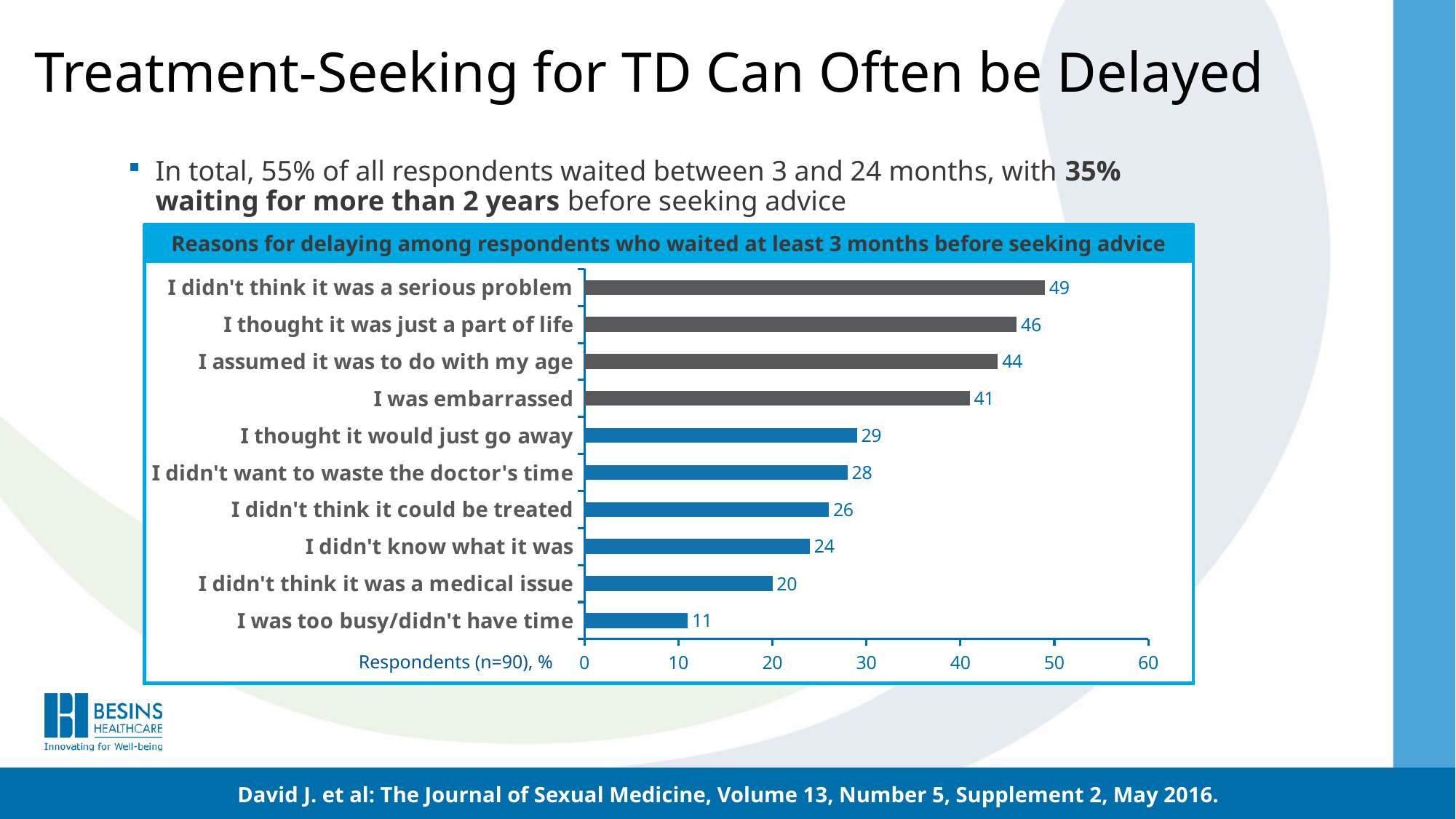
Which is larger: the value for "I thought it would just go away" or "I didn't think it could be treated"? I thought it would just go away Which reason has the lowest value? I was too busy/didn't have time What is the value for "I didn't know what it was"? 24 What is the value for "I was embarrassed"? 41 What is the label of the horizontal axis? Respondents (n=90), % How many reasons are listed in the chart? 10 What percentage of respondents gave "I didn't think it was a serious problem" as a reason for delaying? 49 Which reason has the highest value? I didn't think it was a serious problem What kind of chart is shown on the slide? Bar chart What is the difference between the values for "I thought it was just a part of life" and "I didn't think it was a medical issue"? 26 Is the value for "I assumed it was to do with my age" greater or less than 40? greater What is the title of the chart? Reasons for delaying among respondents who waited at least 3 months before seeking advice